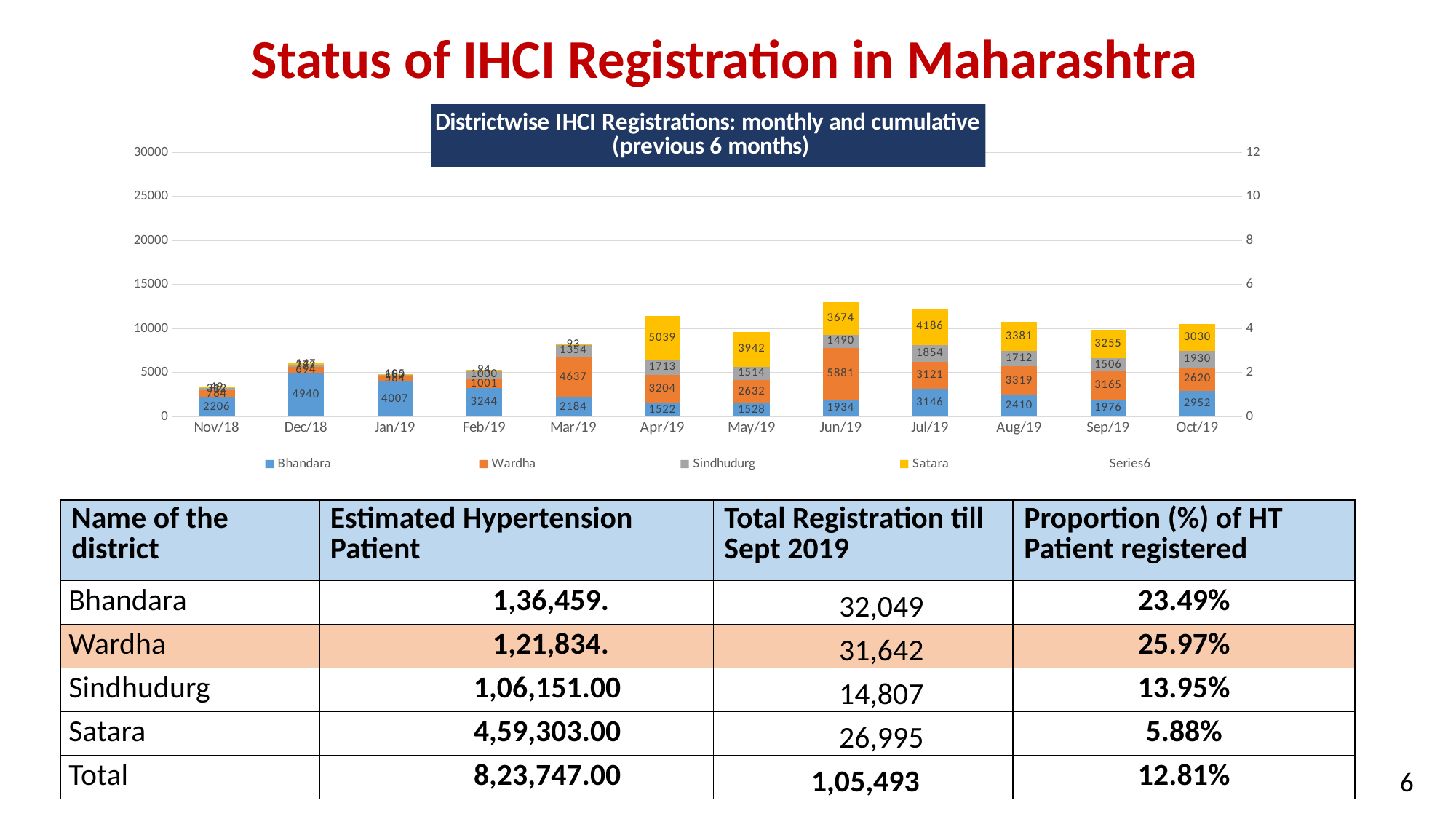
What type of chart is shown on the slide? Stacked bar chart What is the Wardha value for Jun/19? 5881 How many months are shown on the x axis of the chart? 12 What is the Sindhudurg value for Jul/19? 1854 In which month is the Wardha value highest? Jun/19 What is the total of the stacked bar for Jun/19? 12979 What is the difference between the Satara values for Apr/19 and May/19? 1097 How many entries does the chart legend list? 5 What is the Bhandara value for Dec/18? 4940 Is the total stacked bar for Nov/18 greater or less than 5000? less Which is larger, the Bhandara value for Oct/19 or the Wardha value for Oct/19? Bhandara (2952) What is the Satara value for Apr/19? 5039